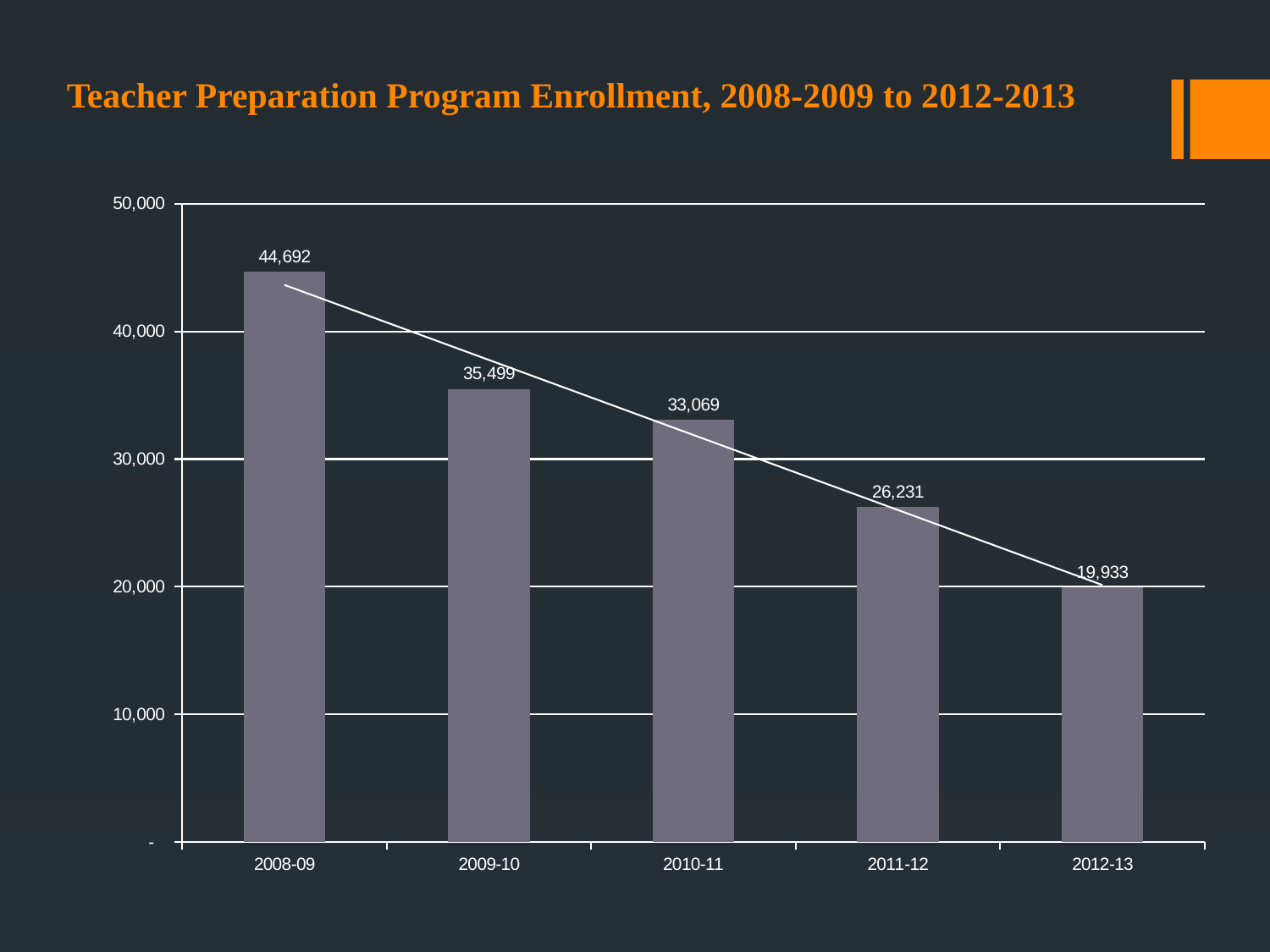
What is the enrollment value for 2010-11? 33,069 What is the difference in enrollment between 2008-09 and 2009-10? 9,193 Which is larger, the enrollment for 2009-10 or for 2011-12? 2009-10 What is the enrollment value for 2012-13? 19,933 Is the enrollment for 2010-11 greater or less than 30,000? greater What is the enrollment value for 2008-09? 44,692 What is the difference in enrollment between 2011-12 and 2012-13? 6,298 How many years are shown on the x axis? 5 Which year has the highest enrollment? 2008-09 Do the enrollment values rise or fall from 2008-09 to 2012-13? fall What kind of chart is shown on the slide? bar chart Which year has the lowest enrollment? 2012-13